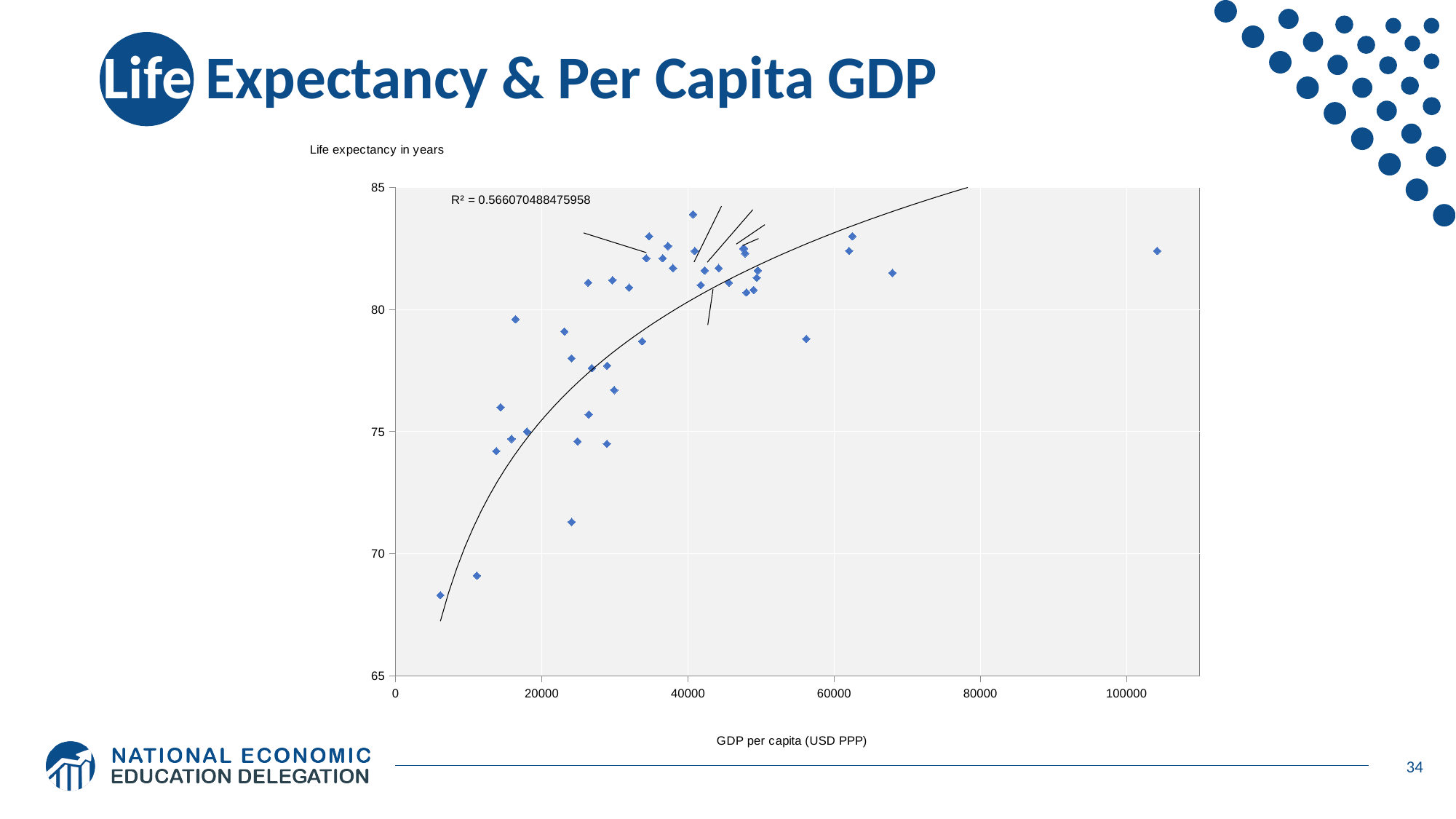
Is the life expectancy of the point with the lowest GDP per capita greater or less than 70? less What is the highest value shown on the vertical axis? 85 Does life expectancy generally rise or fall as GDP per capita increases along the x axis? rise Is the highest life expectancy plotted greater or less than 80? greater What is the highest tick label shown on the horizontal axis? 100000 Is the life expectancy of the point with the highest GDP per capita greater or less than 80? greater What R² value is printed on the chart? R² = 0.566070488475958 What is the label of the vertical axis? Life expectancy in years What kind of chart is shown on the slide? scatter chart What is the label of the horizontal axis? GDP per capita (USD PPP)